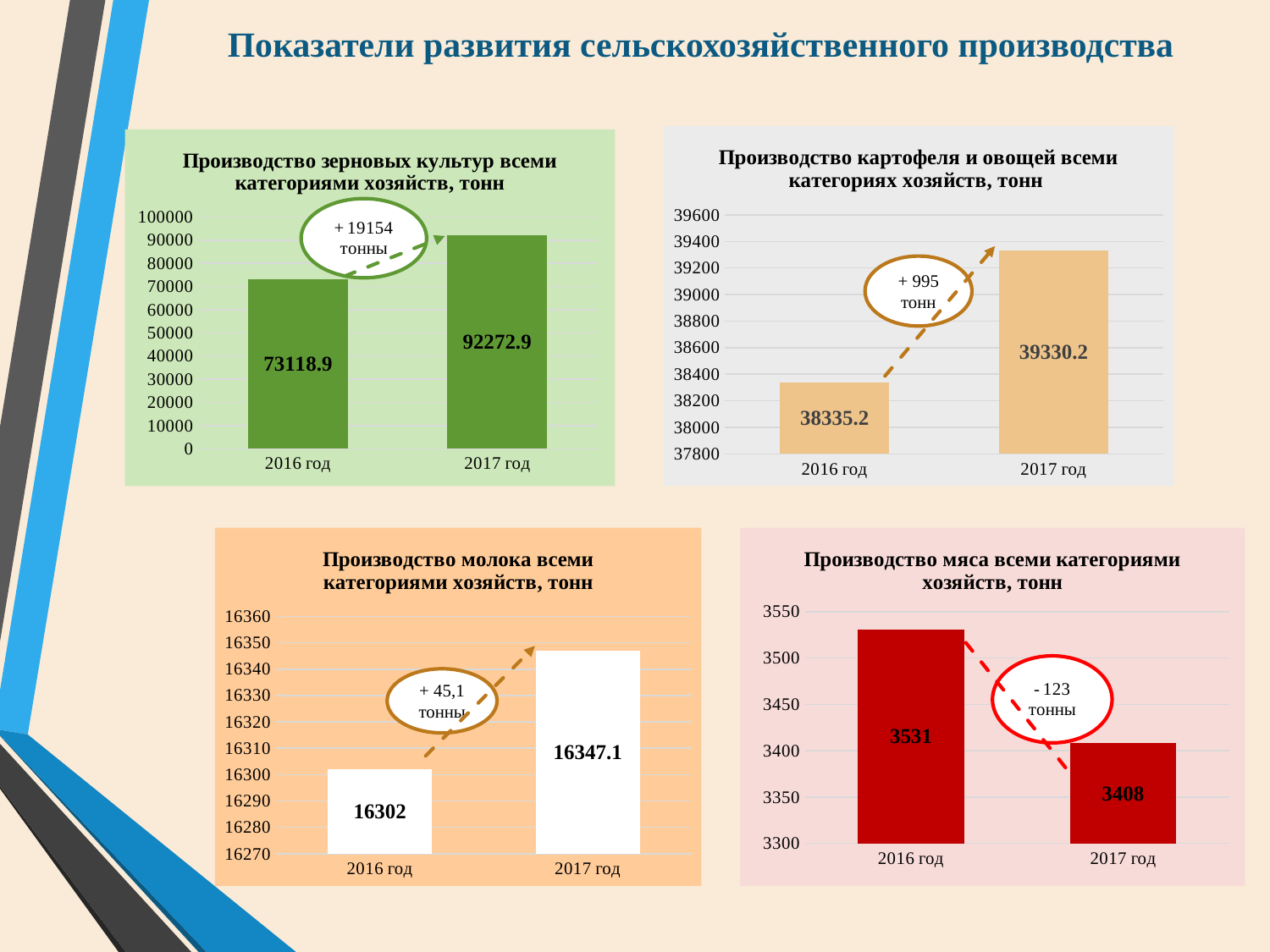
What type of chart is the bottom-right chart (Производство мяса)? bar chart In the bottom-right chart (Производство мяса), what is the value for 2016 год? 3531 In the top-left chart (Производство зерновых культур), what is the value for 2016 год? 73118.9 In the bottom-right chart (Производство мяса), which year has the lower value? 2017 год In the bottom-right chart (Производство мяса), what is the difference between the 2016 год and 2017 год values? 123 In the top-right chart (Производство картофеля и овощей), what is the value for 2016 год? 38335.2 In the top-left chart (Производство зерновых культур), what is the difference between the 2017 год and 2016 год values? 19154 In the bottom-left chart (Производство молока), what is the value for 2017 год? 16347.1 In the top-right chart (Производство картофеля и овощей), by how much did the value increase from 2016 год to 2017 год? 995 In the top-right chart (Производство картофеля и овощей), which year has the higher value? 2017 год In the top-left chart (Производство зерновых культур), what is the value for 2017 год? 92272.9 In the bottom-left chart (Производство молока), do the values rise or fall from 2016 год to 2017 год? rise